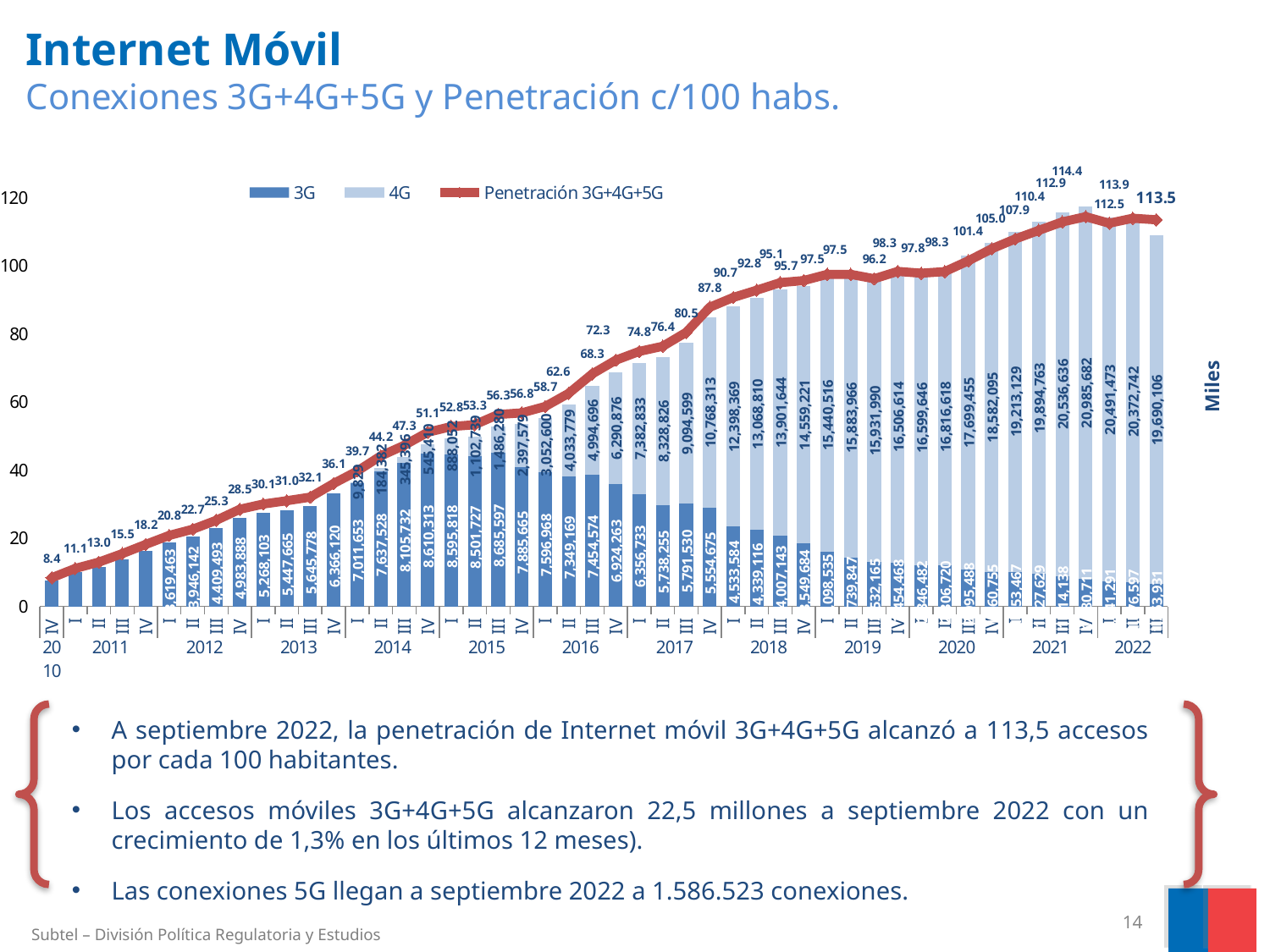
What is the total of the 3G and 4G values for IV 2017? 16,322,988 Does the penetration line generally rise or fall from IV 2010 to III 2022? Rise What is the penetration (Penetración 3G+4G+5G) value for III 2022? 113.5 What is the 4G value for IV 2021? 20,985,682 How many series does the legend list? 3 Is the penetration value for I 2018 greater or less than 80? greater In IV 2016, which is larger, the 3G value or the 4G value? 3G In which quarter does the penetration line reach its highest value, and what is that value? IV 2021, 114.4 What kind of chart is this? Stacked bar chart with a line What is the 3G value for IV 2014? 8,610,313 What is the lowest penetration value shown on the chart? 8.4 What is the difference between the penetration value in IV 2021 and in III 2022? 0.9